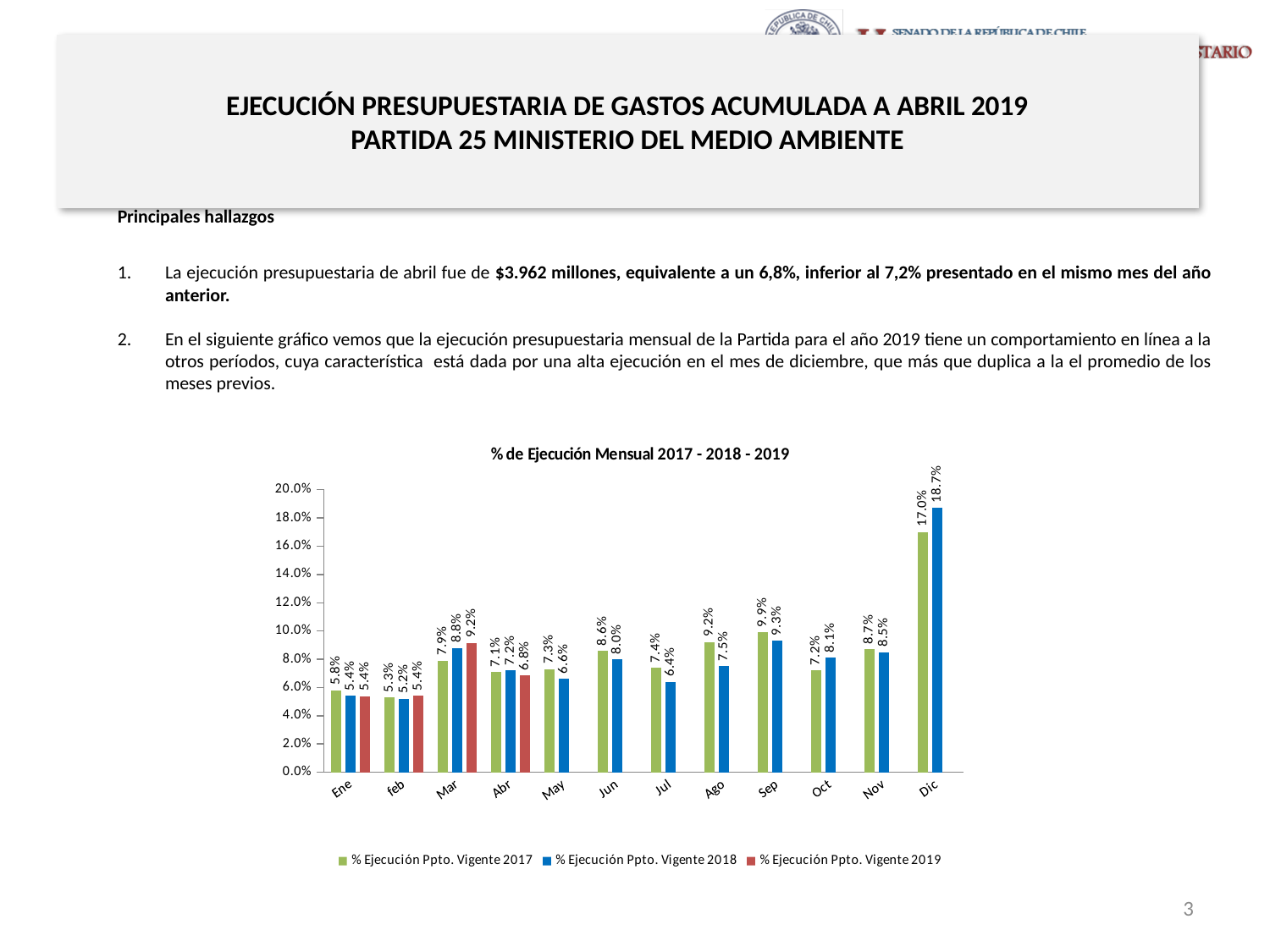
Is the value for Ago in the % Ejecución Ppto. Vigente 2017 series greater or less than 8.0%? greater For Abr, which series has the larger value: % Ejecución Ppto. Vigente 2018 or % Ejecución Ppto. Vigente 2019? % Ejecución Ppto. Vigente 2018 Which month has the lowest value in the % Ejecución Ppto. Vigente 2018 series? feb What kind of chart is shown on the slide? Bar chart How many months are shown on the x axis of the chart? 12 What is the difference between the 2018 and 2017 values for Dic? 1.7% What is the value for Mar in the % Ejecución Ppto. Vigente 2019 series? 9.2% What is the value for Sep in the % Ejecución Ppto. Vigente 2017 series? 9.9% What is the title of the chart? % de Ejecución Mensual 2017 - 2018 - 2019 What is the value for Dic in the % Ejecución Ppto. Vigente 2018 series? 18.7% Which month has the highest value in the % Ejecución Ppto. Vigente 2017 series? Dic How many series does the chart legend list? 3